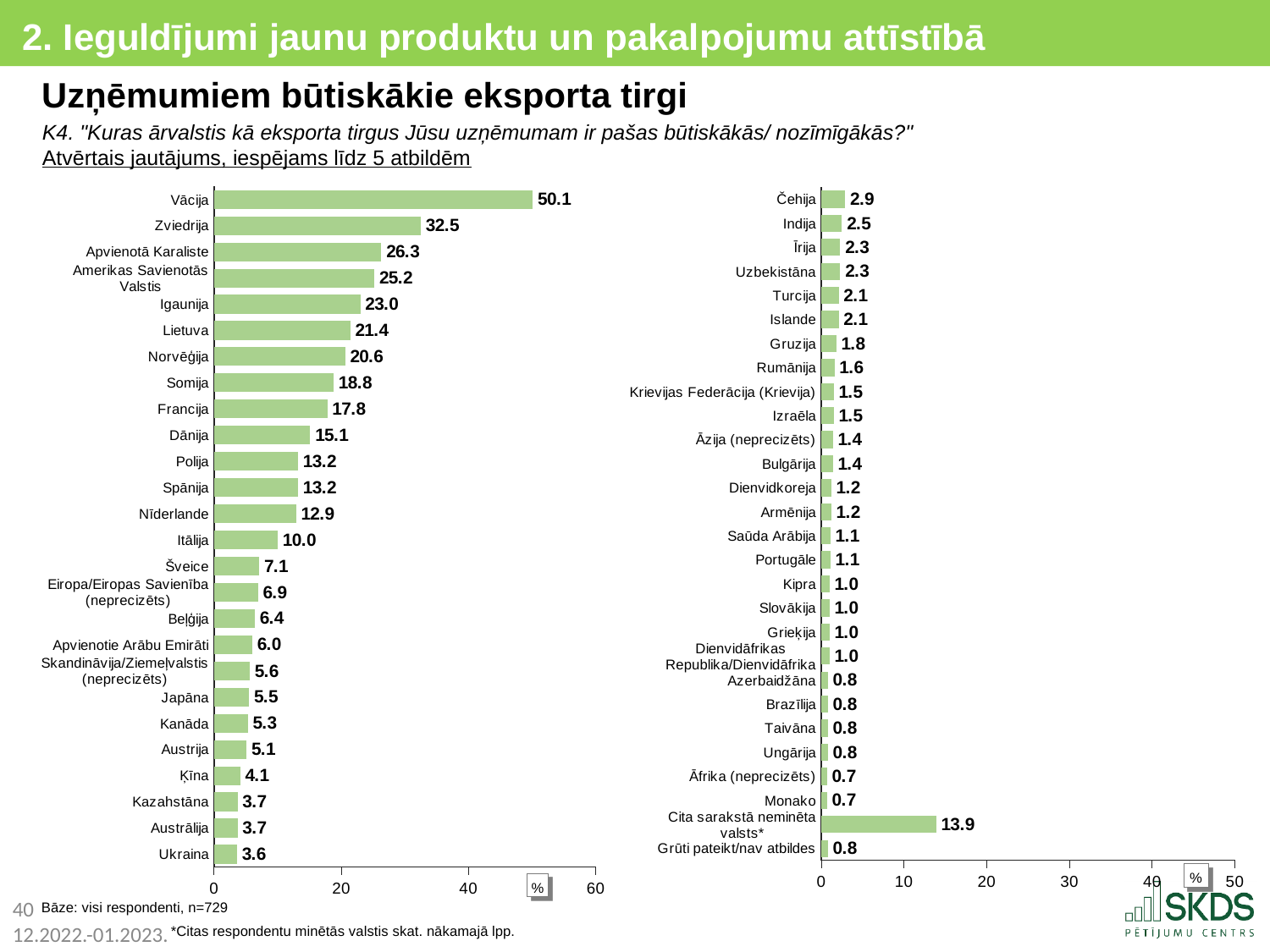
On the left chart, which is larger, the value for Igaunija or the value for Somija? Igaunija On the left chart, which category has the highest value? Vācija On the left chart, what is the value for Vācija? 50.1 On the left chart, what is the value for Lietuva? 21.4 On the left chart, what is the difference between the values for Vācija and Zviedrija? 17.6 On the right chart, which category has the highest value? Cita sarakstā neminēta valsts* On the left chart, which category has the lowest value? Ukraina On the right chart, what is the value for Cita sarakstā neminēta valsts*? 13.9 How many categories are shown on the left chart? 26 What type of chart is the left chart? Bar chart On the right chart, which is larger, the value for Indija or the value for Gruzija? Indija On the right chart, what is the value for Čehija? 2.9